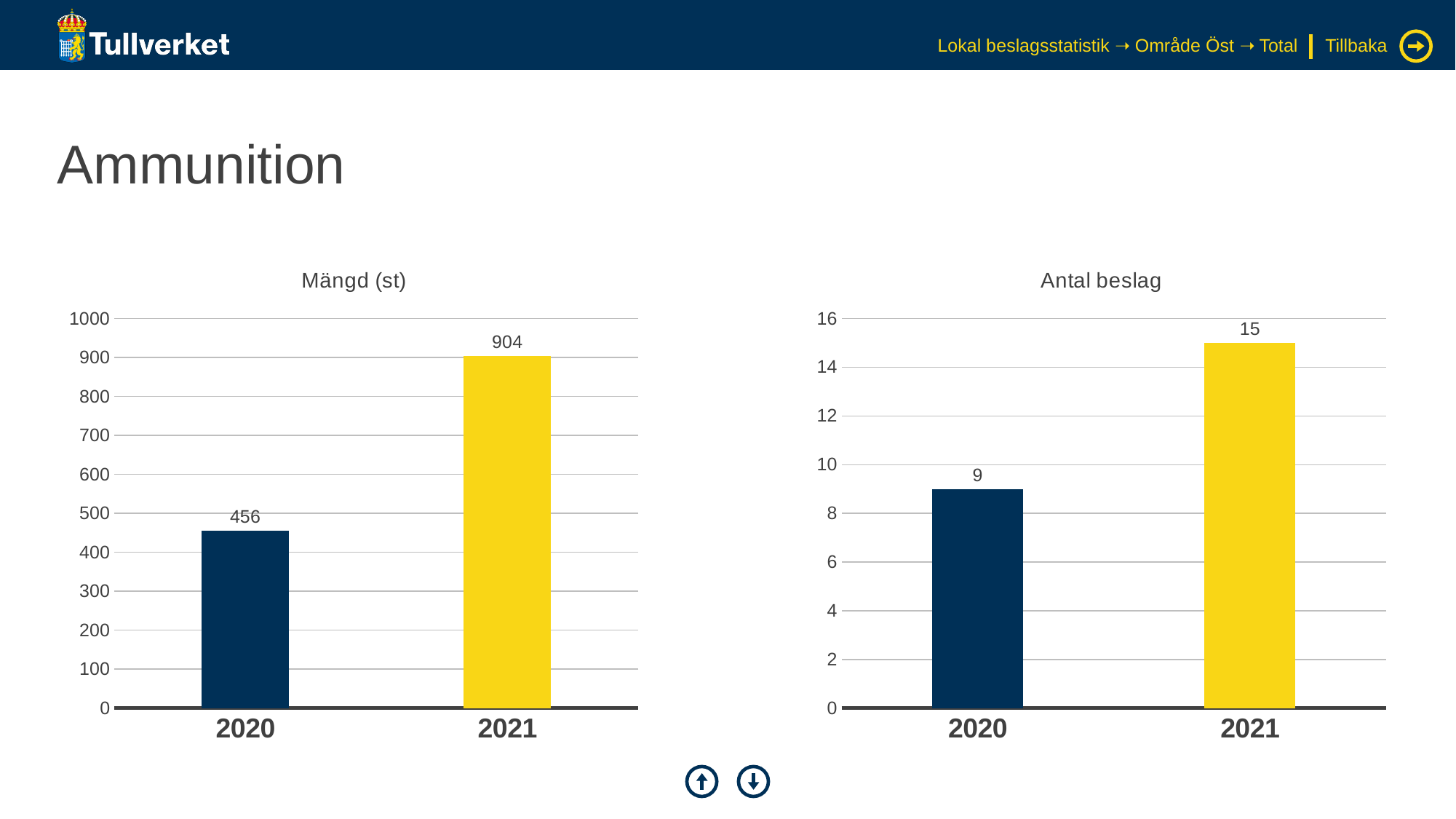
In the 'Antal beslag' chart, what is the difference between the 2021 and 2020 values? 6 In the 'Antal beslag' chart, which year has the lowest value? 2020 In the 'Mängd (st)' chart, what is the value for 2020? 456 How many categories are shown on the x axis of the 'Mängd (st)' chart? 2 In the 'Mängd (st)' chart, which year has the highest value? 2021 In the 'Mängd (st)' chart, what is the value for 2021? 904 In the 'Antal beslag' chart, is the value for 2020 greater or less than 10? less In the 'Antal beslag' chart, what is the value for 2021? 15 In the 'Mängd (st)' chart, do the values rise or fall from 2020 to 2021? rise In the 'Mängd (st)' chart, what is the difference between the 2021 and 2020 values? 448 In the 'Antal beslag' chart, what is the value for 2020? 9 What kind of chart is the 'Antal beslag' chart? bar chart